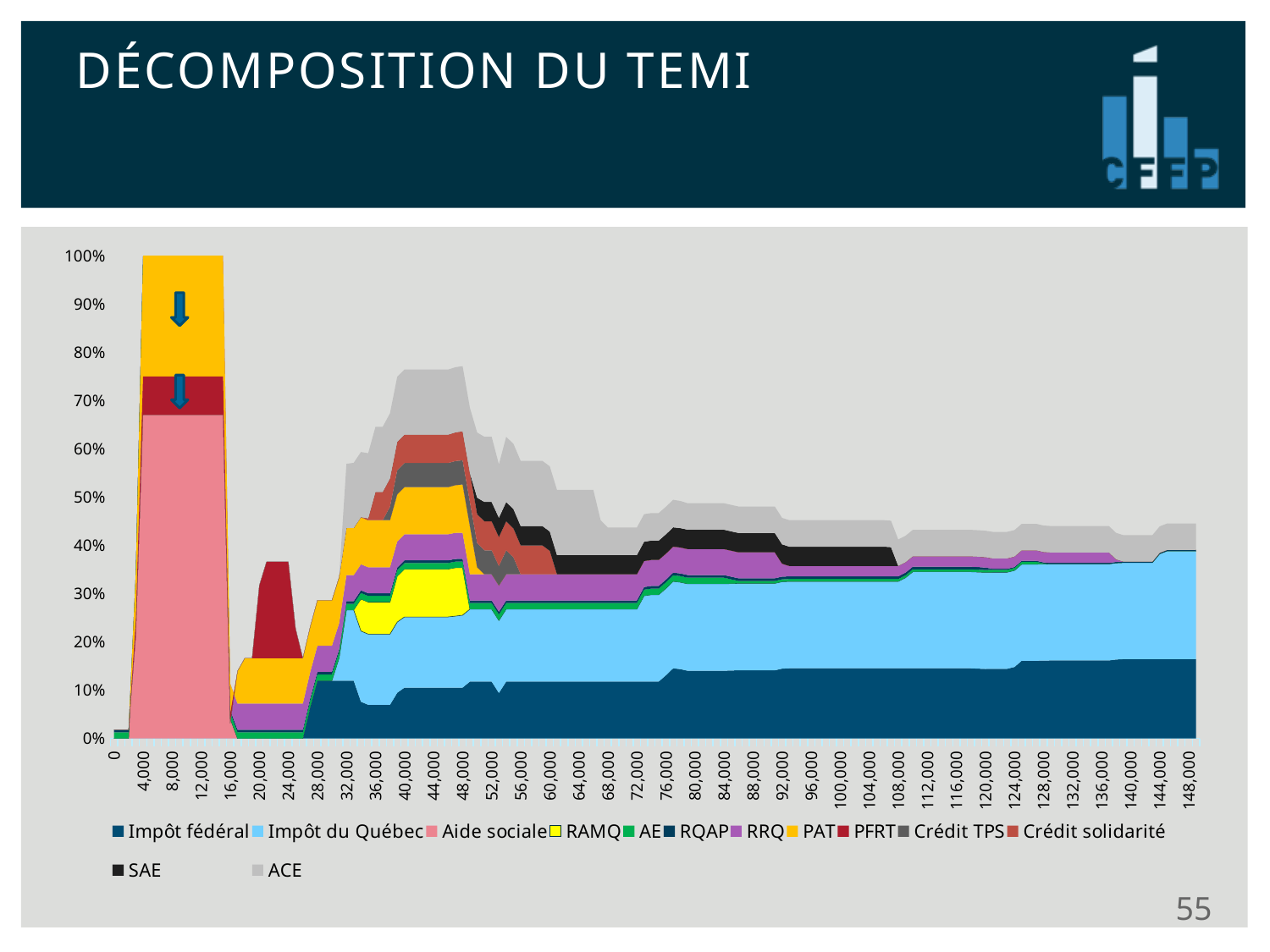
Which series accounts for the largest part of the stack at an income of 8,000? Aide sociale Does the total stacked value rise or fall between incomes of 12,000 and 16,000? fall Is the total stacked value at an income of 20,000 greater or less than 50%? less How many series does the legend list? 13 What is the title of the slide containing the chart? DÉCOMPOSITION DU TEMI Is the total stacked value at an income of 40,000 greater or less than 70%? greater How many tick labels are shown on the x axis? 38 Is the total stacked value at an income of 8,000 greater or less than 90%? greater Which series is shown in light grey at the top of the stack? ACE What kind of chart is shown on the slide? Stacked area chart